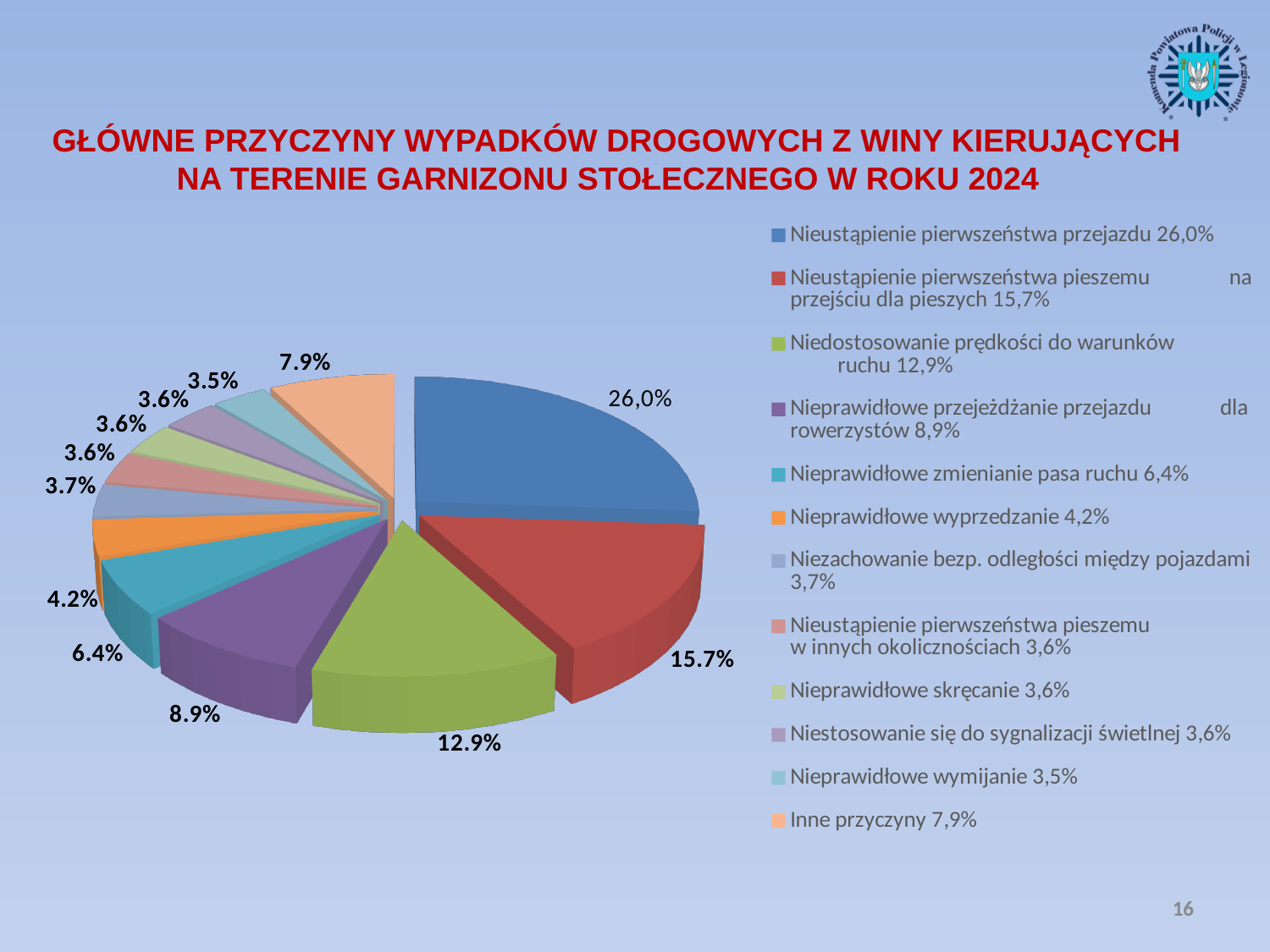
What value is shown for 'Niedostosowanie prędkości do warunków ruchu'? 12.9% Which is larger: the share for 'Nieprawidłowe przejeżdżanie przejazdu dla rowerzystów' or for 'Inne przyczyny'? Nieprawidłowe przejeżdżanie przejazdu dla rowerzystów What value is shown for 'Inne przyczyny'? 7.9% What value is shown for 'Nieprawidłowe zmienianie pasa ruchu'? 6.4% What is the difference in percentage points between 'Niedostosowanie prędkości do warunków ruchu' (12.9%) and 'Nieprawidłowe przejeżdżanie przejazdu dla rowerzystów' (8.9%)? 4.0 percentage points Which cause has the largest share of the pie? Nieustąpienie pierwszeństwa przejazdu Which cause has the smallest share of the pie? Nieprawidłowe wymijanie What colour is the slice for 'Nieustąpienie pierwszeństwa pieszemu na przejściu dla pieszych'? Red How many slices does the pie chart have? 12 What share of the pie is labelled for 'Nieustąpienie pierwszeństwa przejazdu'? 26,0% What type of chart is shown on the slide? Pie chart How many entries does the legend list? 12